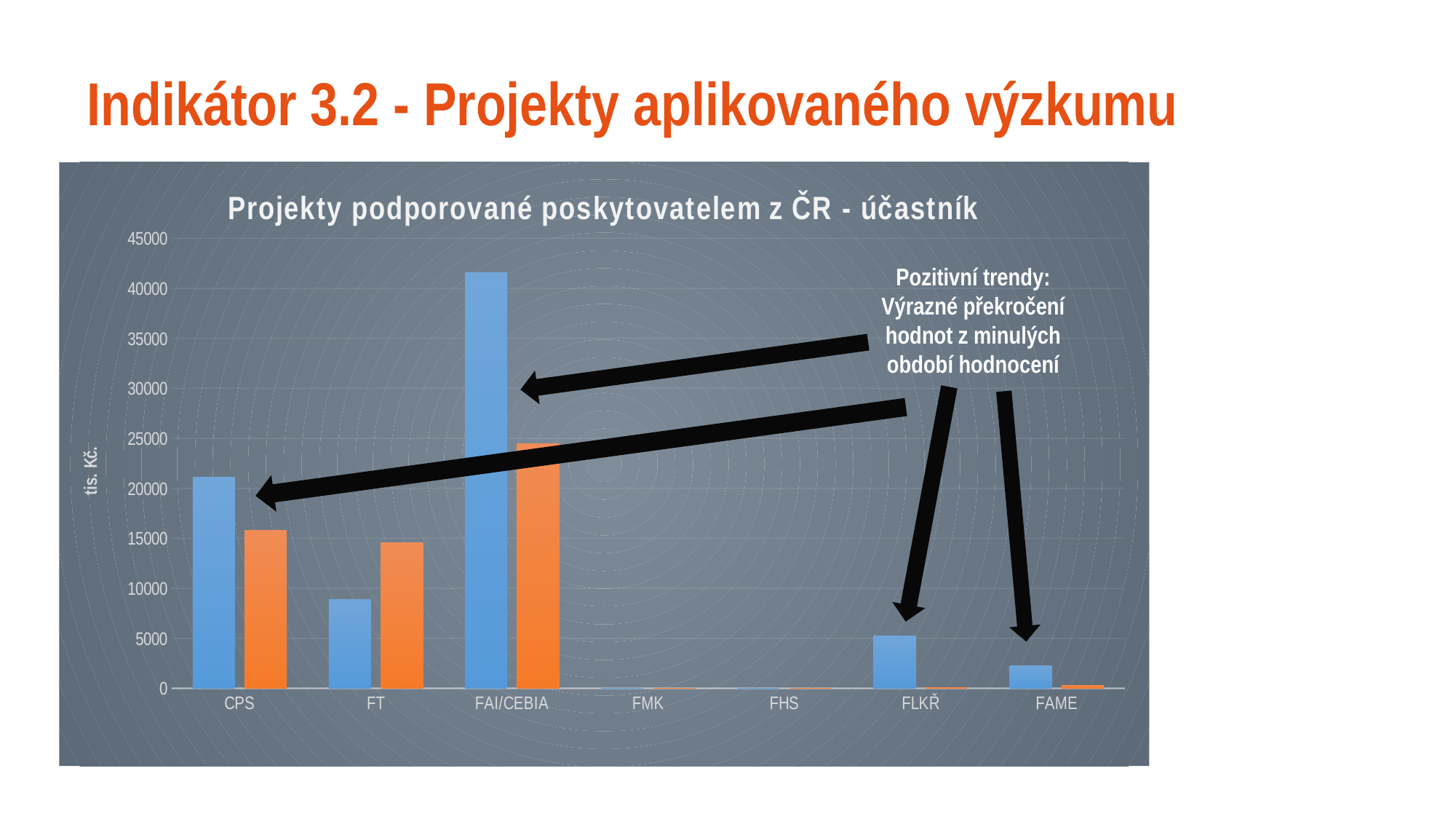
Which is larger for FT, the blue bar or the orange bar? the orange bar Which category has the tallest blue bar? FAI/CEBIA Which category has the tallest orange bar? FAI/CEBIA How many categories are shown on the x axis of the chart? 7 Is the blue bar for FT greater or less than 10000? less What kind of chart is shown on the slide? bar chart What is the title of the chart? Projekty podporované poskytovatelem z ČR - účastník Is the orange bar for FAI/CEBIA greater or less than 20000? greater Which is larger for CPS, the blue bar or the orange bar? the blue bar Is the blue bar for CPS greater or less than 20000? greater What is the label of the vertical axis? tis. Kč.